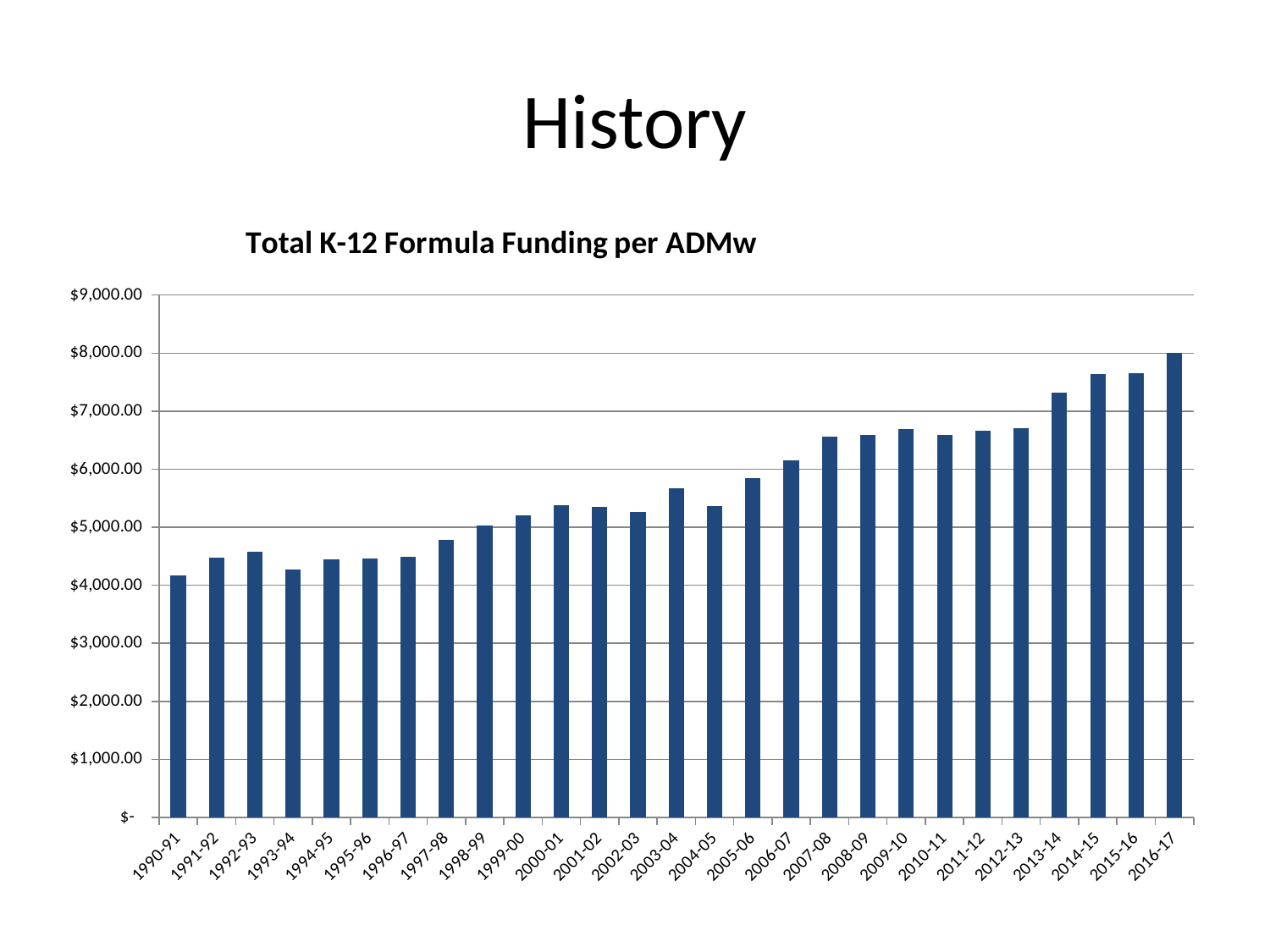
What kind of chart is shown on the slide? Bar chart Is the value for 2013-14 greater or less than $7,000.00? greater How many school years are plotted on the x axis? 27 Overall, do the values rise or fall from 1990-91 to 2016-17? rise Which school year has the highest funding per ADMw? 2016-17 Is the value for 2003-04 greater or less than $5,000.00? greater Is the value for 2016-17 greater or less than $7,000.00? greater Which is larger, the value for 2007-08 or the value for 2004-05? 2007-08 What is the title of the chart? Total K-12 Formula Funding per ADMw What colour are the bars in the chart? Dark blue